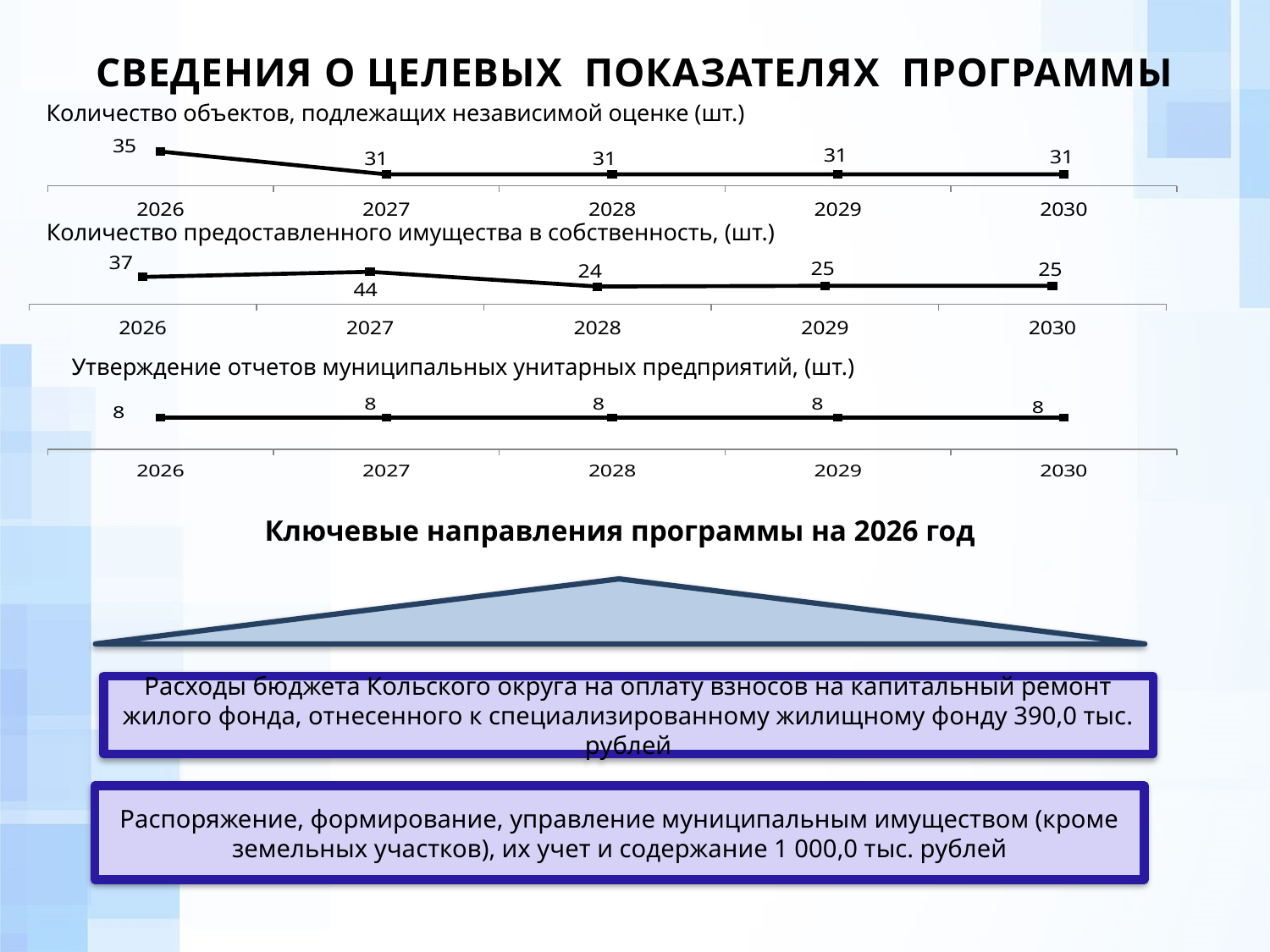
What kind of chart is 'Количество объектов, подлежащих независимой оценке (шт.)'? line chart In the chart 'Количество предоставленного имущества в собственность, (шт.)', what is the difference between the values for 2027 and 2028? 20 In the chart 'Количество предоставленного имущества в собственность, (шт.)', which year has the highest value? 2027 In the chart 'Количество объектов, подлежащих независимой оценке (шт.)', what is the difference between the values for 2026 and 2027? 4 In the chart 'Количество предоставленного имущества в собственность, (шт.)', which year has the lowest value? 2028 In the chart 'Количество объектов, подлежащих независимой оценке (шт.)', what is the value for 2026? 35 In the chart 'Количество объектов, подлежащих независимой оценке (шт.)', what is the value for 2028? 31 In the chart 'Количество предоставленного имущества в собственность, (шт.)', which is larger, the value for 2026 or the value for 2029? 2026 In the chart 'Утверждение отчетов муниципальных унитарных предприятий, (шт.)', what is the value for 2030? 8 In the chart 'Количество предоставленного имущества в собственность, (шт.)', what is the value for 2027? 44 In the chart 'Количество объектов, подлежащих независимой оценке (шт.)', which year has the highest value? 2026 How many years are plotted in the chart 'Утверждение отчетов муниципальных унитарных предприятий, (шт.)'? 5